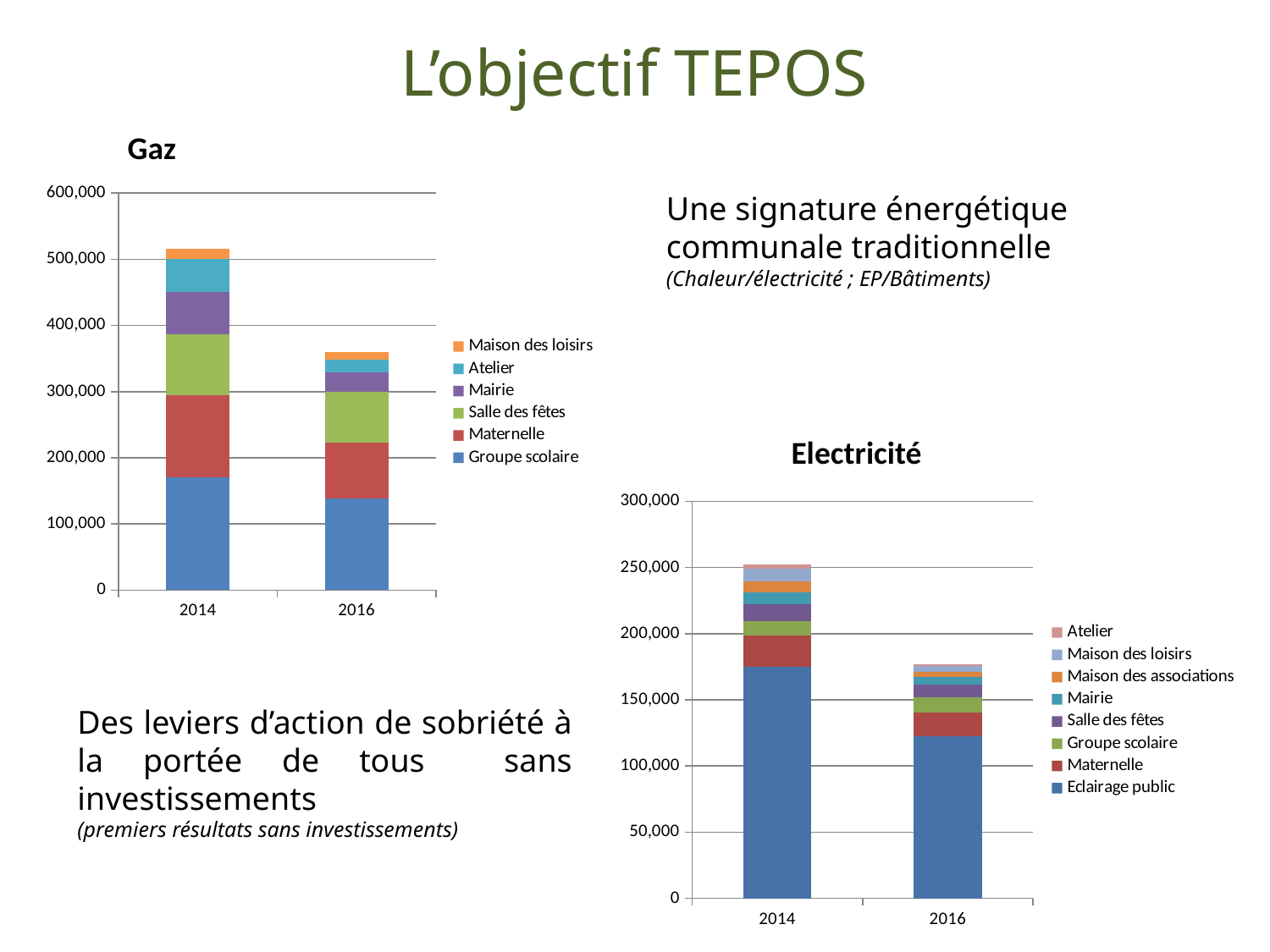
In the Electricité chart, is the total for 2016 greater or less than 200,000? less How many categories are shown on the x axis of the Electricité chart? 2 What is the title of the chart on the right side of the slide? Electricité How many series does the legend of the Electricité chart list? 8 In the Gaz chart, is the total for 2014 greater or less than 500,000? greater What type of chart is the Gaz chart? stacked bar chart In the Electricité chart, is the Eclairage public value for 2014 greater or less than 150,000? greater In the Gaz chart, which series is shown at the bottom of each stacked bar? Groupe scolaire In the Electricité chart, do the totals rise or fall from 2014 to 2016? fall How many series does the legend of the Gaz chart list? 6 In the Gaz chart, which year has the higher total, 2014 or 2016? 2014